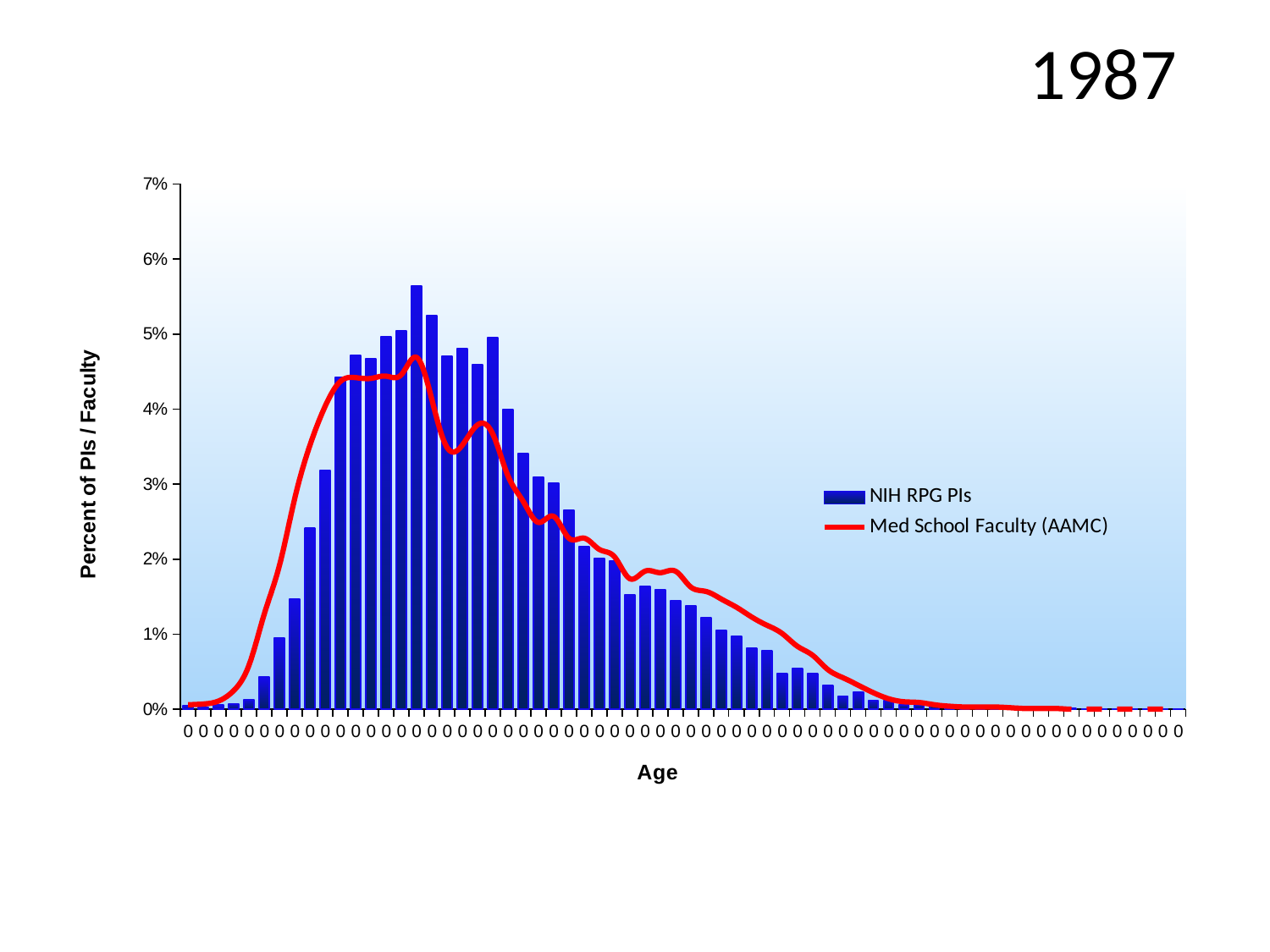
What is the highest value shown on the y axis? 7% Which series is drawn as a red line? Med School Faculty (AAMC) Is the tallest NIH RPG PIs bar greater or less than 5%? greater After reaching their peak, do the NIH RPG PIs bar values rise or fall moving to the right along the Age axis? fall Is the highest point of the Med School Faculty (AAMC) line greater or less than 5%? less What kind of chart is shown on the slide? A bar chart with a line overlay Which series reaches a higher peak value, NIH RPG PIs or Med School Faculty (AAMC)? NIH RPG PIs Is the tallest NIH RPG PIs bar greater or less than 6%? less Which series is drawn as blue bars? NIH RPG PIs How many series does the legend list? 2